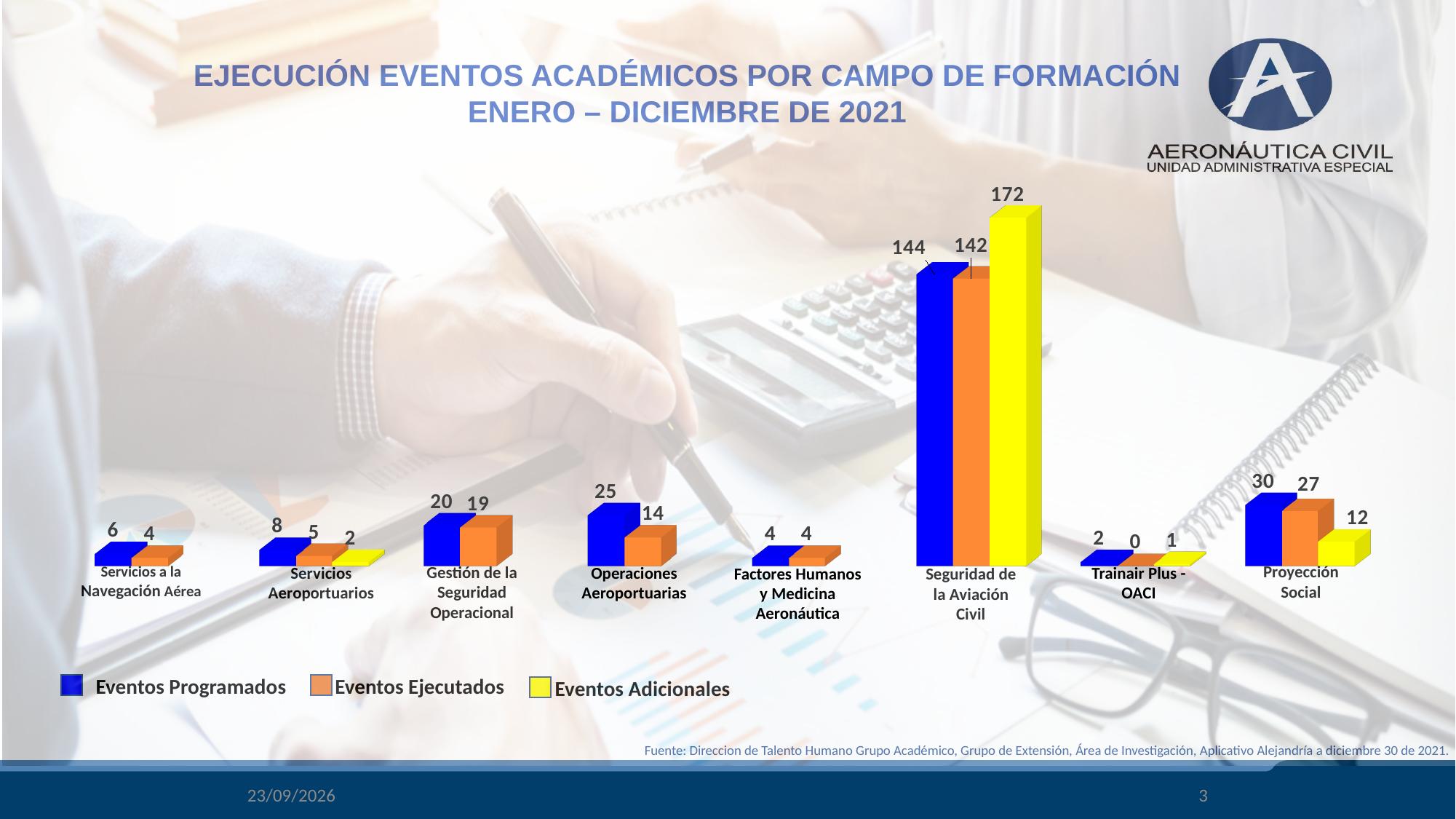
Which is larger for Seguridad de la Aviación Civil: Eventos Ejecutados or Eventos Adicionales? Eventos Adicionales What is the value of Eventos Adicionales for Seguridad de la Aviación Civil? 172 What kind of chart is shown on the slide? Bar chart How many series does the legend list? 3 Which category has the lowest value of Eventos Programados? Trainair Plus - OACI What is the value of Eventos Ejecutados for Trainair Plus - OACI? 0 What is the difference between Eventos Programados and Eventos Ejecutados for Operaciones Aeroportuarias? 11 What is the value of Eventos Ejecutados for Operaciones Aeroportuarias? 14 How many categories are shown on the x axis of the chart? 8 What is the value of Eventos Programados for Seguridad de la Aviación Civil? 144 What is the difference between Eventos Programados and Eventos Ejecutados for Proyección Social? 3 Which category has the highest value of Eventos Programados? Seguridad de la Aviación Civil